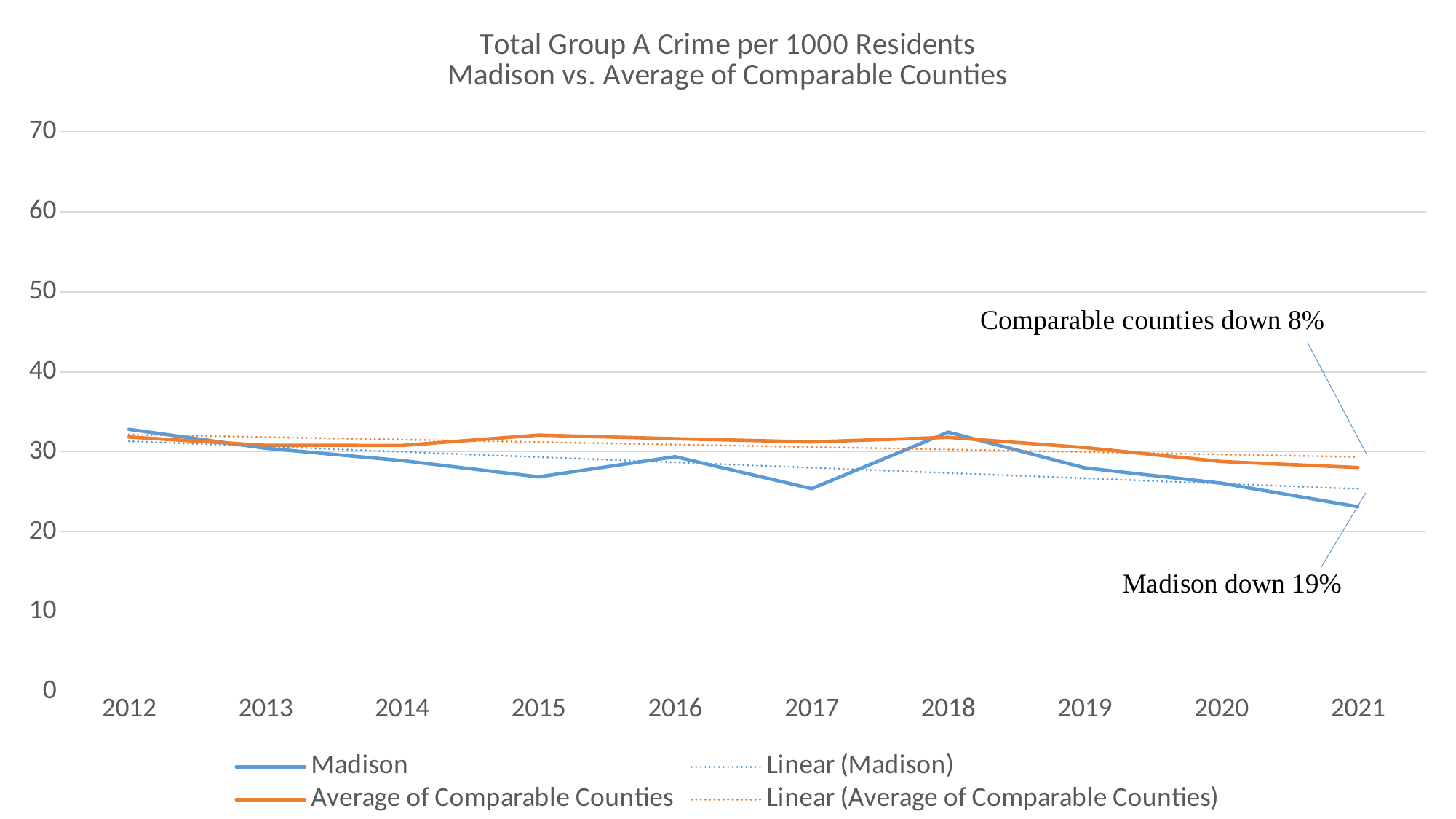
How many entries does the legend list? 4 Is the Madison value for 2021 greater or less than 30? less According to the annotation on the chart, by what percentage is Madison down? 19% Does the Madison line generally rise or fall from 2012 to 2021? fall In which year is the Madison value lowest? 2021 What kind of chart is shown on the slide? line chart In 2021, which is larger: Madison or Average of Comparable Counties? Average of Comparable Counties How many years are shown on the x axis? 10 In 2017, which is larger: Madison or Average of Comparable Counties? Average of Comparable Counties Is the Madison value for 2012 greater or less than 30? greater Is the Average of Comparable Counties value for 2015 greater or less than 30? greater